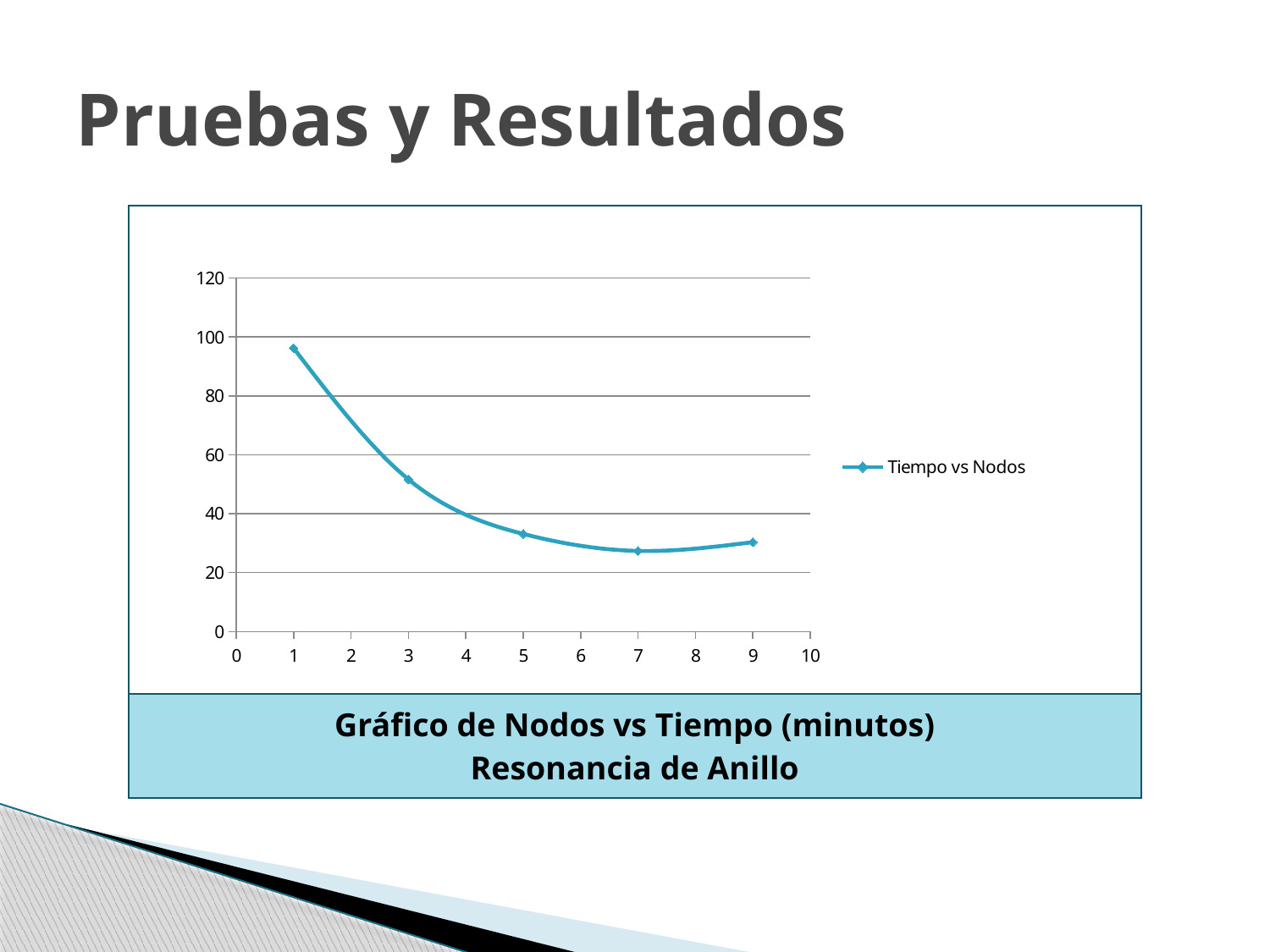
What caption is shown below the chart? Gráfico de Nodos vs Tiempo (minutos) Resonancia de Anillo Which is larger, the value at x = 1 or the value at x = 3? x = 1 At which x value does the line reach its highest point? 1 Is the value at x = 3 greater or less than 60? less How many series does the legend list? 1 How many data points are plotted on the line? 5 What is the name of the series shown in the legend? Tiempo vs Nodos Do the values rise or fall from x = 1 to x = 7? fall Is the value at x = 5 greater or less than 40? less Is the value at x = 7 greater or less than 20? greater What kind of chart is shown on the slide? line chart